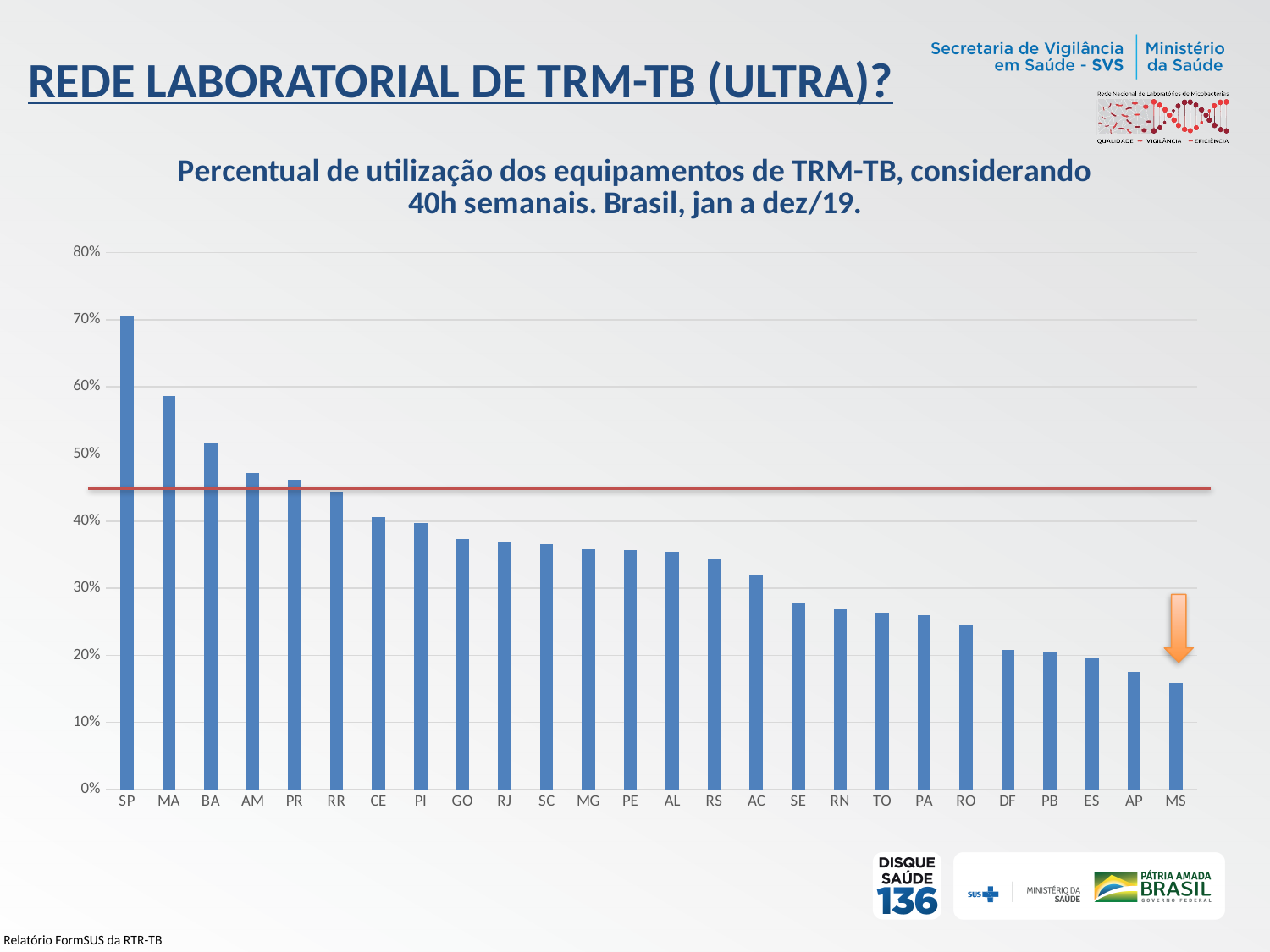
Which state has the highest percentage of TRM-TB equipment utilization? SP Which state has the lowest percentage of TRM-TB equipment utilization? MS Is the value for MA greater or less than 50%? greater Do the values rise or fall moving from left to right along the x axis? fall Which has a lower value, AP or TO? AP What kind of chart is shown on the slide? bar chart Is the value for MS greater or less than 20%? less What period does the chart title say the data covers? jan a dez/19 How many states are shown on the x axis of the chart? 26 Which has a higher value, BA or RS? BA